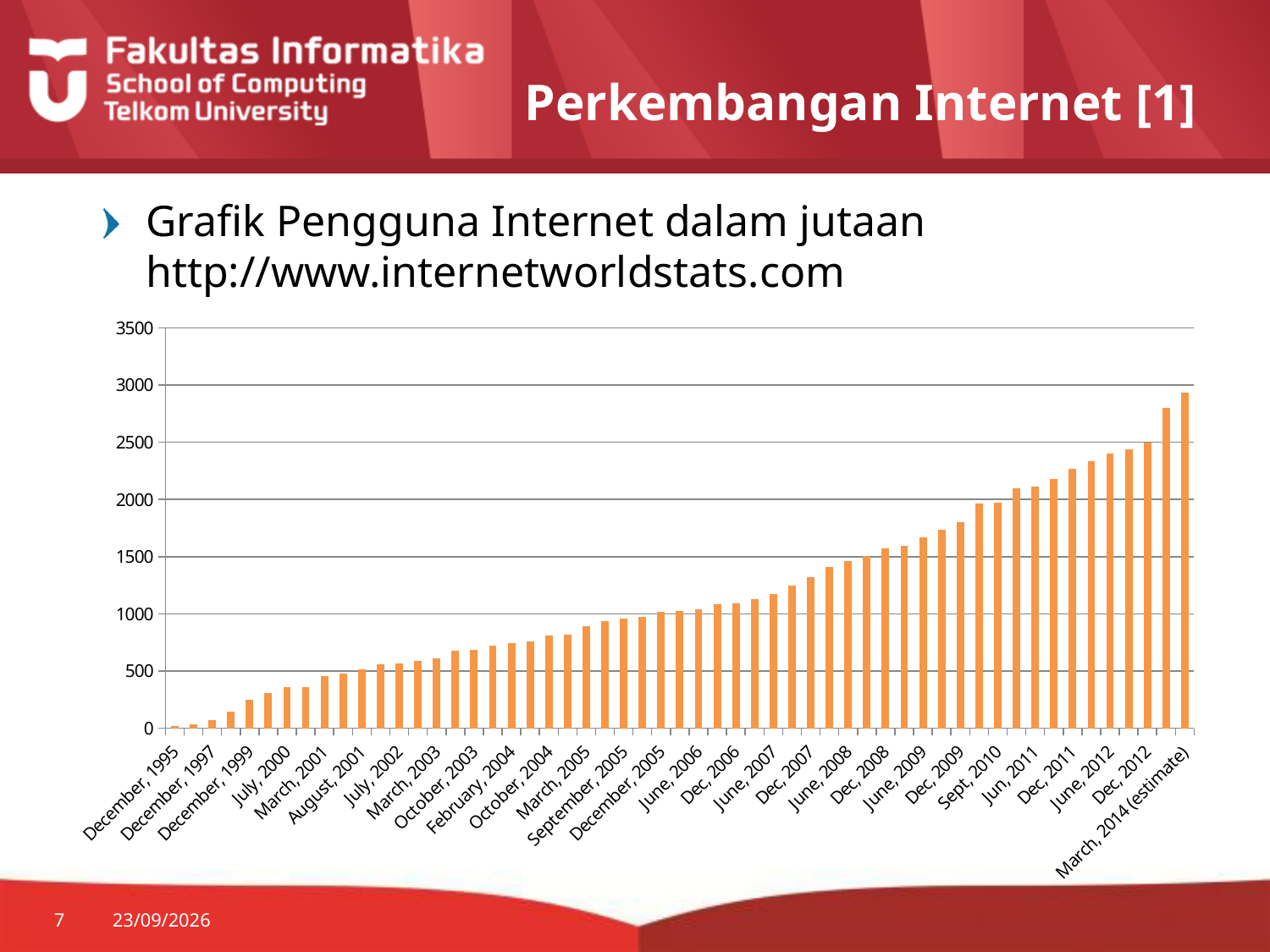
Which category has the highest value in the chart? March, 2014 (estimate) Is the value for March, 2014 (estimate) greater or less than 2500? greater What is the highest value shown on the vertical axis? 3500 Which category has the lowest value in the chart? December, 1995 Which is larger, the value for Dec, 2007 or the value for July, 2000? Dec, 2007 Is the value for December, 1999 greater or less than 500? less What colour are the bars in the chart? orange Is the value for December, 1995 greater or less than 500? less Do the values generally rise or fall along the x axis from December 1995 to March 2014? rise What kind of chart is shown on the slide? bar chart